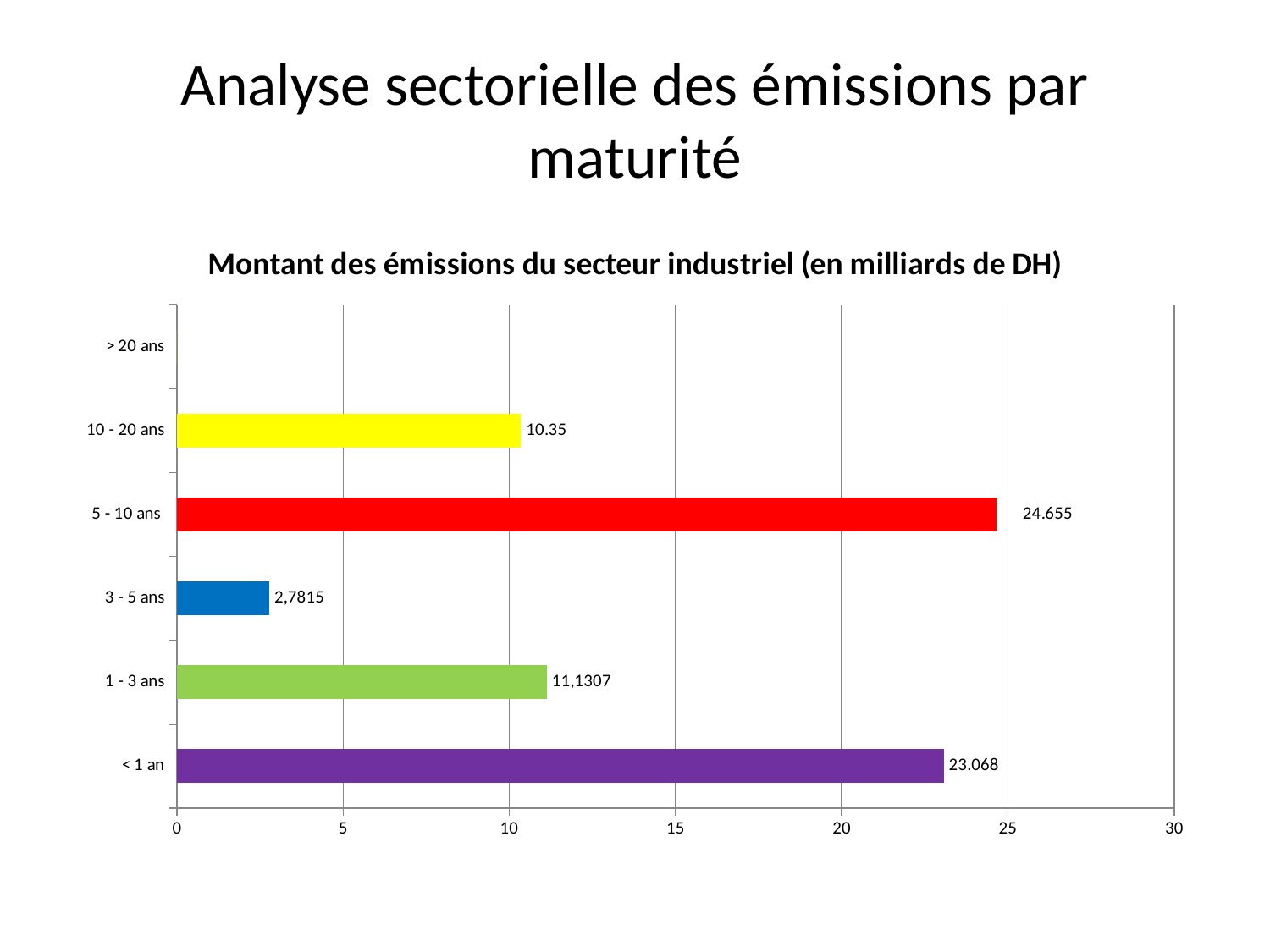
What is the value for the 1 - 3 ans category? 11,1307 What is the value for the 5 - 10 ans category? 24.655 What is the value for the 10 - 20 ans category? 10.35 How many maturity categories are shown on the chart? 6 Which maturity category has the highest value? 5 - 10 ans Which is larger, the value for < 1 an or the value for 1 - 3 ans? < 1 an What kind of chart is shown on the slide? bar chart Is the value for 10 - 20 ans greater or less than 15? less What is the value for the < 1 an category? 23.068 What is the value for the 3 - 5 ans category? 2,7815 Which maturity category has the lowest value? > 20 ans What is the difference between the values for 5 - 10 ans and < 1 an? 1.587